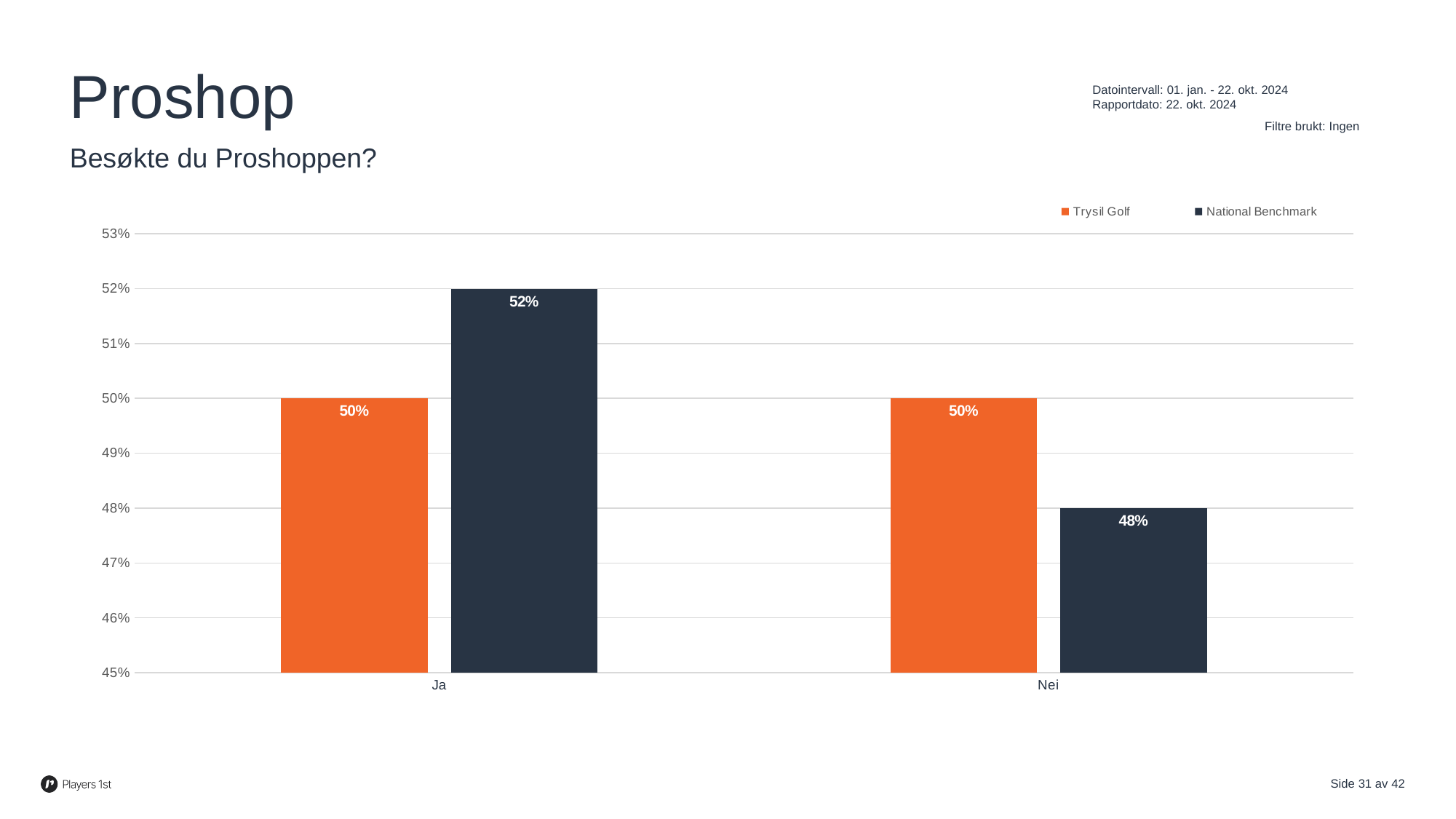
Which category has the highest National Benchmark value? Ja What is the difference between the National Benchmark values for Ja and Nei? 4% What is the value for Trysil Golf in the Nei category? 50% What is the value for Trysil Golf in the Ja category? 50% Which category has the lowest National Benchmark value? Nei How many categories are shown on the x axis? 2 What kind of chart is shown on the slide? Bar chart In the Nei category, which series has the larger value, Trysil Golf or National Benchmark? Trysil Golf What is the value for National Benchmark in the Ja category? 52% What is the value for National Benchmark in the Nei category? 48% In the Ja category, which series has the larger value, Trysil Golf or National Benchmark? National Benchmark How many series does the legend list? 2